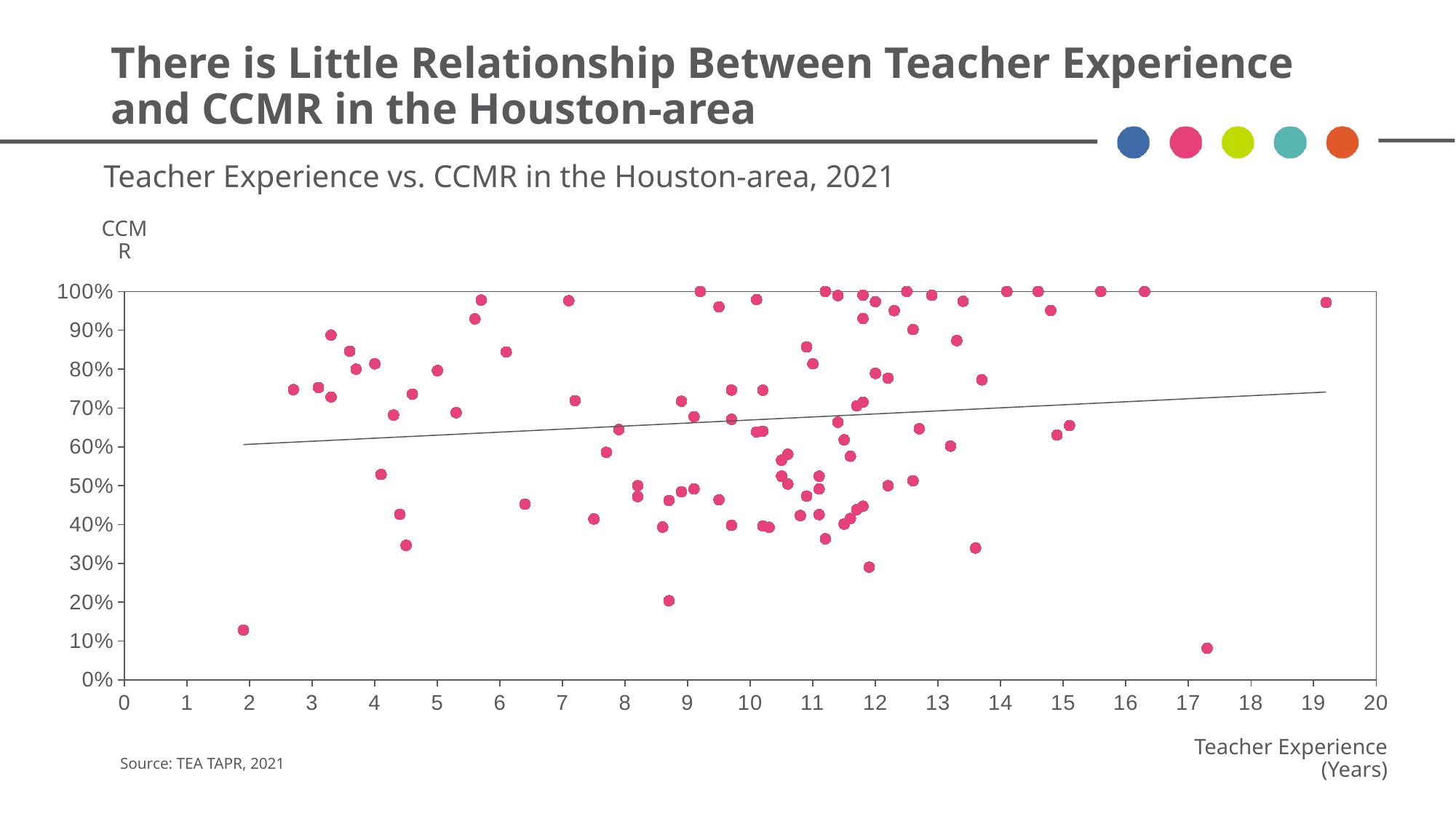
What is the source cited for the chart data? TEA TAPR, 2021 Which point has a higher CCMR value: the one at about 2 years of experience or the one at about 17 years of experience? The one at about 2 years Is the CCMR value for the point at about 2 years of teacher experience greater or less than 20%? less What is the highest value shown on the x axis of the chart? 20 What kind of chart is shown on the slide? Scatter plot Does the trend line in the chart rise or fall as teacher experience increases? Rises Is the CCMR value for the point at about 19 years of teacher experience greater or less than 90%? greater What is the highest value shown on the y axis of the chart? 100% What is the title of the chart? Teacher Experience vs. CCMR in the Houston-area, 2021 What variable is plotted on the x axis of the chart? Teacher Experience (Years) Is the CCMR value for the point at about 17 years of teacher experience greater or less than 10%? less